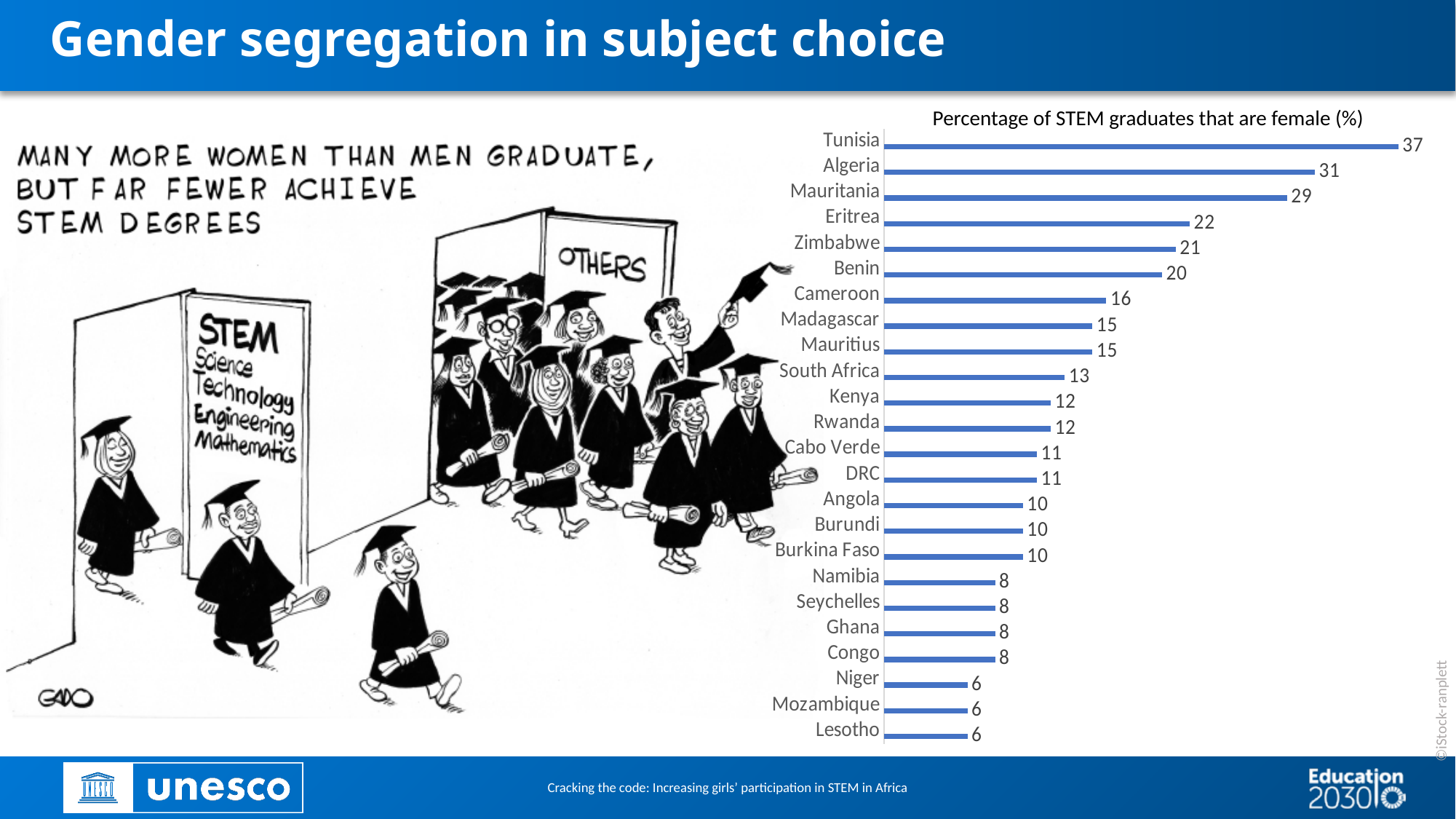
What kind of chart is used to show the percentage of STEM graduates that are female? Bar chart What is the title of the chart? Percentage of STEM graduates that are female (%) How many countries are shown on the chart? 24 What is the difference between the values for Tunisia and Algeria? 6 Which has a higher value, Mauritania or Zimbabwe? Mauritania What is the percentage of STEM graduates that are female in Tunisia? 37 What is the difference between the values for Eritrea and Namibia? 14 Which has a higher value, Benin or Kenya? Benin What is the value for South Africa? 13 Which country has the highest percentage of female STEM graduates? Tunisia What value is shown for Cameroon? 16 What is the lowest value shown on the chart? 6